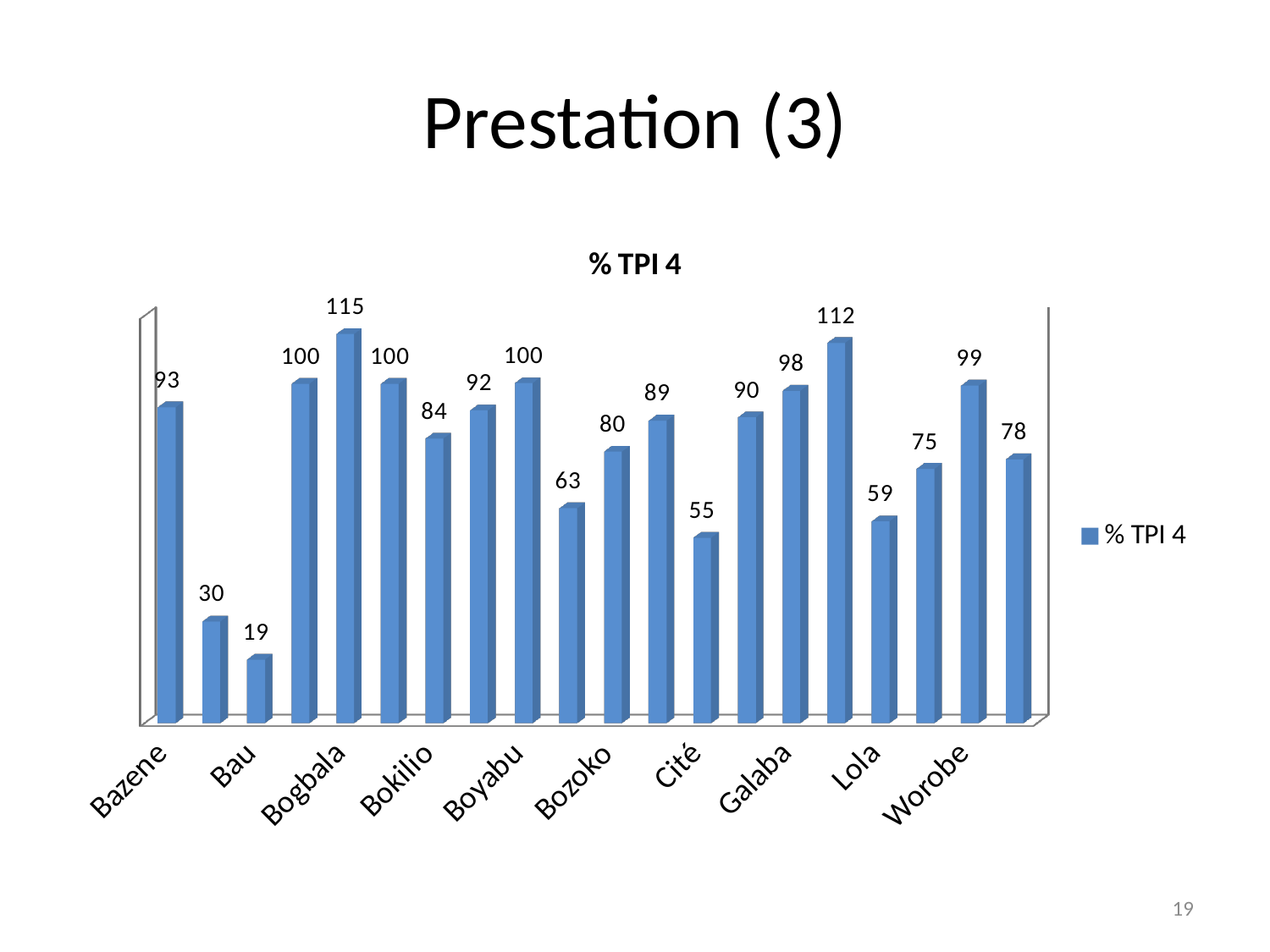
Which has the larger value, Galaba or Lola? Galaba What is the highest value shown in the chart? 115 What is the difference between the values for Bogbala and Bau? 96 What kind of chart is shown on the slide? bar chart What is the value for Bogbala? 115 What is the value for Cité? 55 What is the value for Bazene? 93 What is the title of the chart? % TPI 4 How many series does the legend list? 1 How many bars are plotted in the chart? 20 What is the lowest value shown in the chart? 19 What is the value for Bau? 19